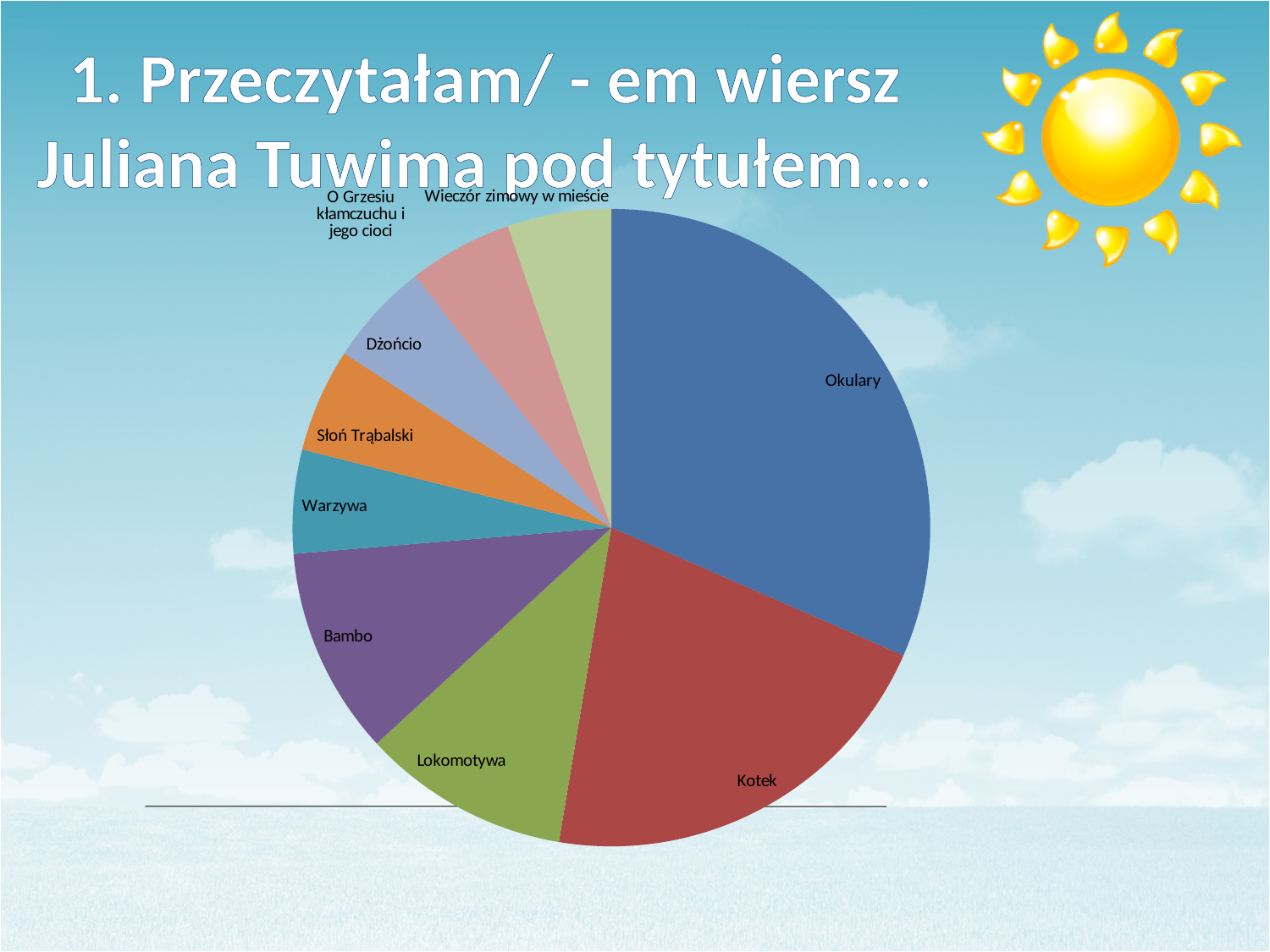
Which is larger in the pie chart, Bambo or Warzywa? Bambo What colour is the Okulary slice in the pie chart? blue Which is larger in the pie chart, Kotek or Dżońcio? Kotek What colour is the Kotek slice in the pie chart? red Which is larger in the pie chart, Okulary or Bambo? Okulary Which slice of the pie chart is the largest? Okulary How many slices does the pie chart have? 9 What kind of chart is shown on the slide? pie chart